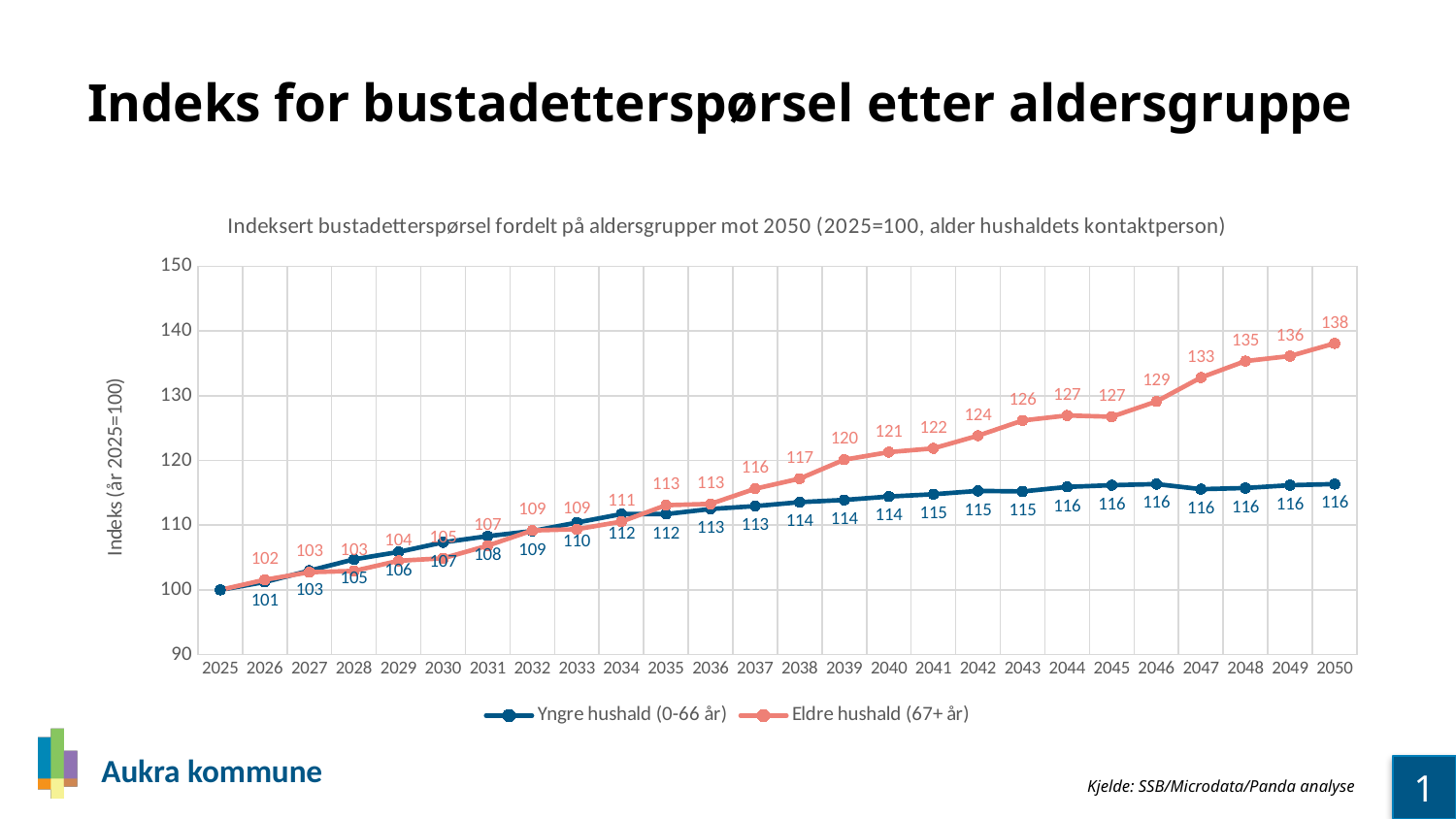
Is the value for Eldre hushald (67+ år) in 2046 greater or less than 130? less What is the value for Yngre hushald (0-66 år) in 2050? 116 What is the value for Eldre hushald (67+ år) in 2043? 126 What is the value for Yngre hushald (0-66 år) in 2040? 114 How many years are plotted on the x axis? 26 Which series has the higher value in 2047, Yngre hushald (0-66 år) or Eldre hushald (67+ år)? Eldre hushald (67+ år) Does the Eldre hushald (67+ år) series rise or fall from 2025 to 2050? rise What kind of chart is shown on the slide? line chart How many series does the legend list? 2 What is the difference between Eldre hushald (67+ år) and Yngre hushald (0-66 år) in 2050? 22 In which year does Eldre hushald (67+ år) reach its highest value? 2050 What is the value for Eldre hushald (67+ år) in 2050? 138